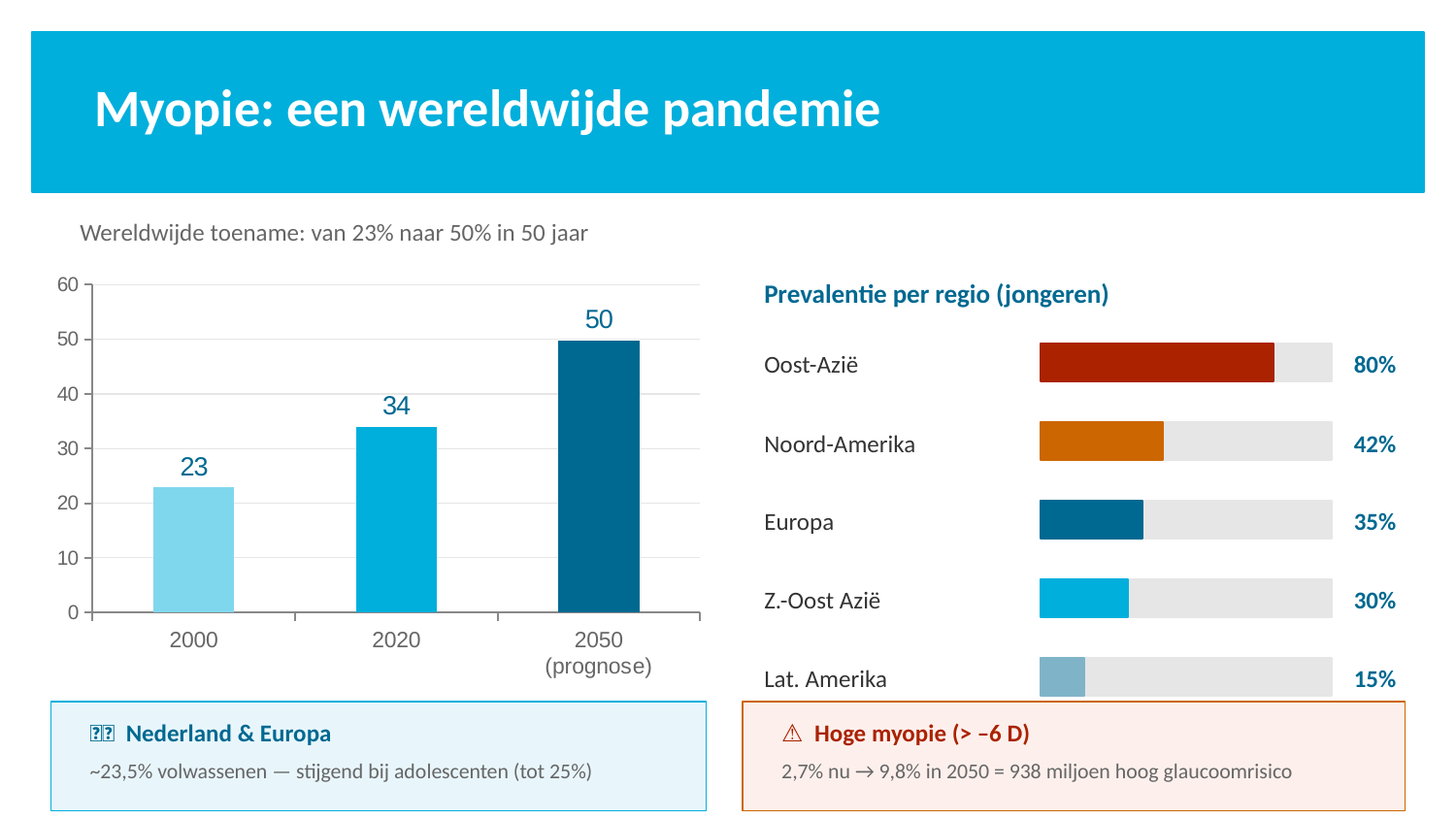
In the bar chart on the left, which year has the lowest value? 2000 In the 'Prevalentie per regio (jongeren)' chart, which is larger, the value for Europa or the value for Z.-Oost Azië? Europa In the 'Prevalentie per regio (jongeren)' chart, which region has the lowest value? Lat. Amerika In the 'Prevalentie per regio (jongeren)' chart, what is the value for Noord-Amerika? 42% In the bar chart on the left, do the values rise or fall from 2000 to 2050? rise How many bars are in the bar chart on the left? 3 In the 'Prevalentie per regio (jongeren)' chart, what is the difference between the values for Oost-Azië and Europa? 45% In the bar chart on the left, what is the value for 2050 (prognose)? 50 What kind of chart is the chart on the left? bar chart In the bar chart on the left, what is the difference between the values for 2050 (prognose) and 2000? 27 In the bar chart on the left, what is the value for 2020? 34 In the 'Prevalentie per regio (jongeren)' chart, which region has the highest value? Oost-Azië